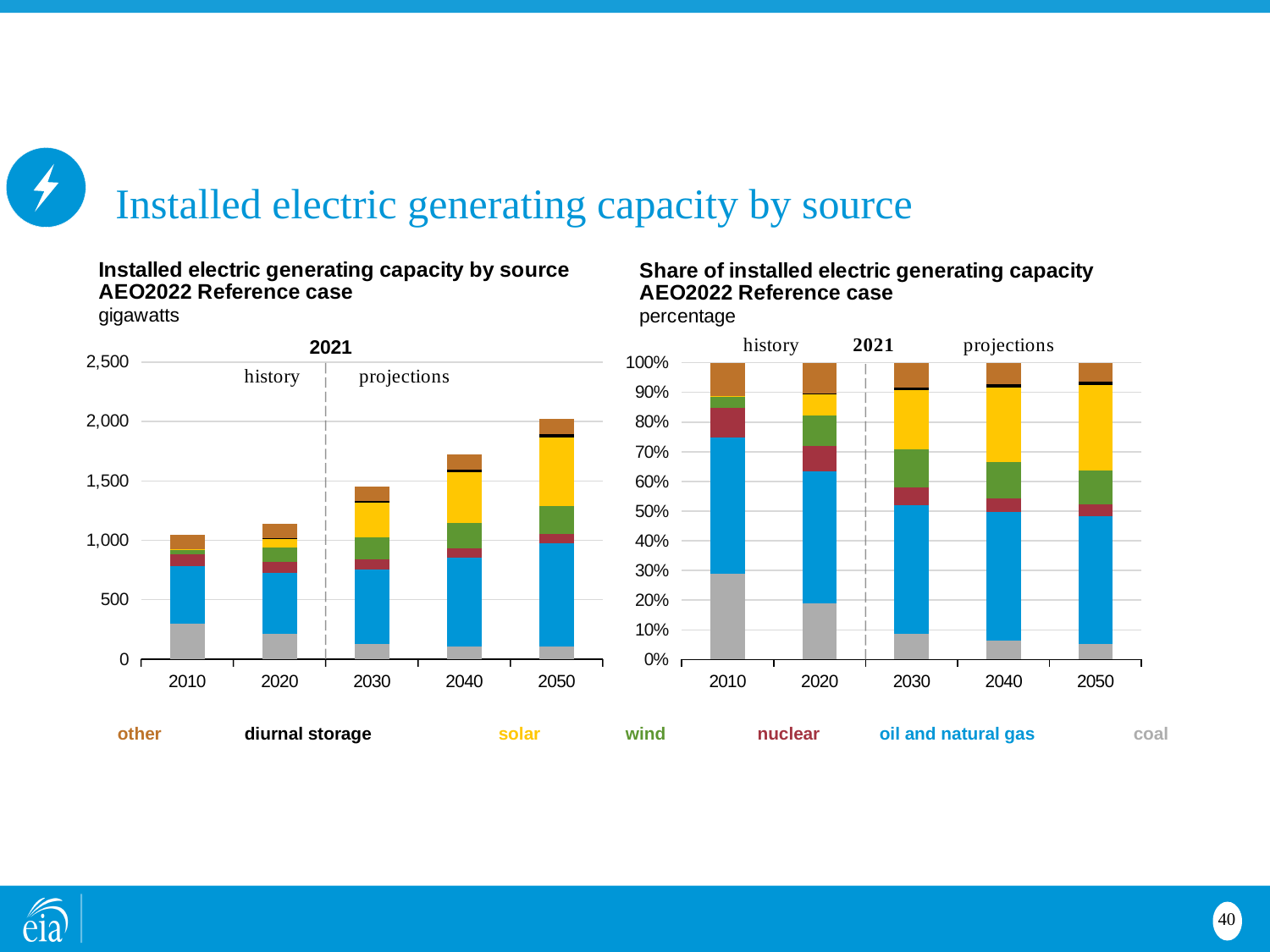
In the left chart, 'Installed electric generating capacity by source', does total installed capacity rise or fall from 2010 to 2050? rise In the right chart, 'Share of installed electric generating capacity', is the coal share larger in 2010 or in 2050? 2010 In the left chart, 'Installed electric generating capacity by source', which year has the highest total installed capacity? 2050 How many sources does the shared legend below the charts list? 7 In the right chart, 'Share of installed electric generating capacity', is the coal share in 2050 greater or less than 10%? less What unit is used on the y axis of the left chart, 'Installed electric generating capacity by source'? gigawatts What kind of chart is the left chart, 'Installed electric generating capacity by source'? stacked bar chart In the left chart, 'Installed electric generating capacity by source', which year has the lowest total installed capacity? 2010 In the right chart, 'Share of installed electric generating capacity', does the coal share rise or fall from 2010 to 2050? fall In the left chart, 'Installed electric generating capacity by source', is the total capacity for 2040 greater or less than 1,500 gigawatts? greater In the left chart, 'Installed electric generating capacity by source', is the total capacity for 2010 greater or less than 1,500 gigawatts? less How many years are shown on the x axis of the left chart, 'Installed electric generating capacity by source'? 5